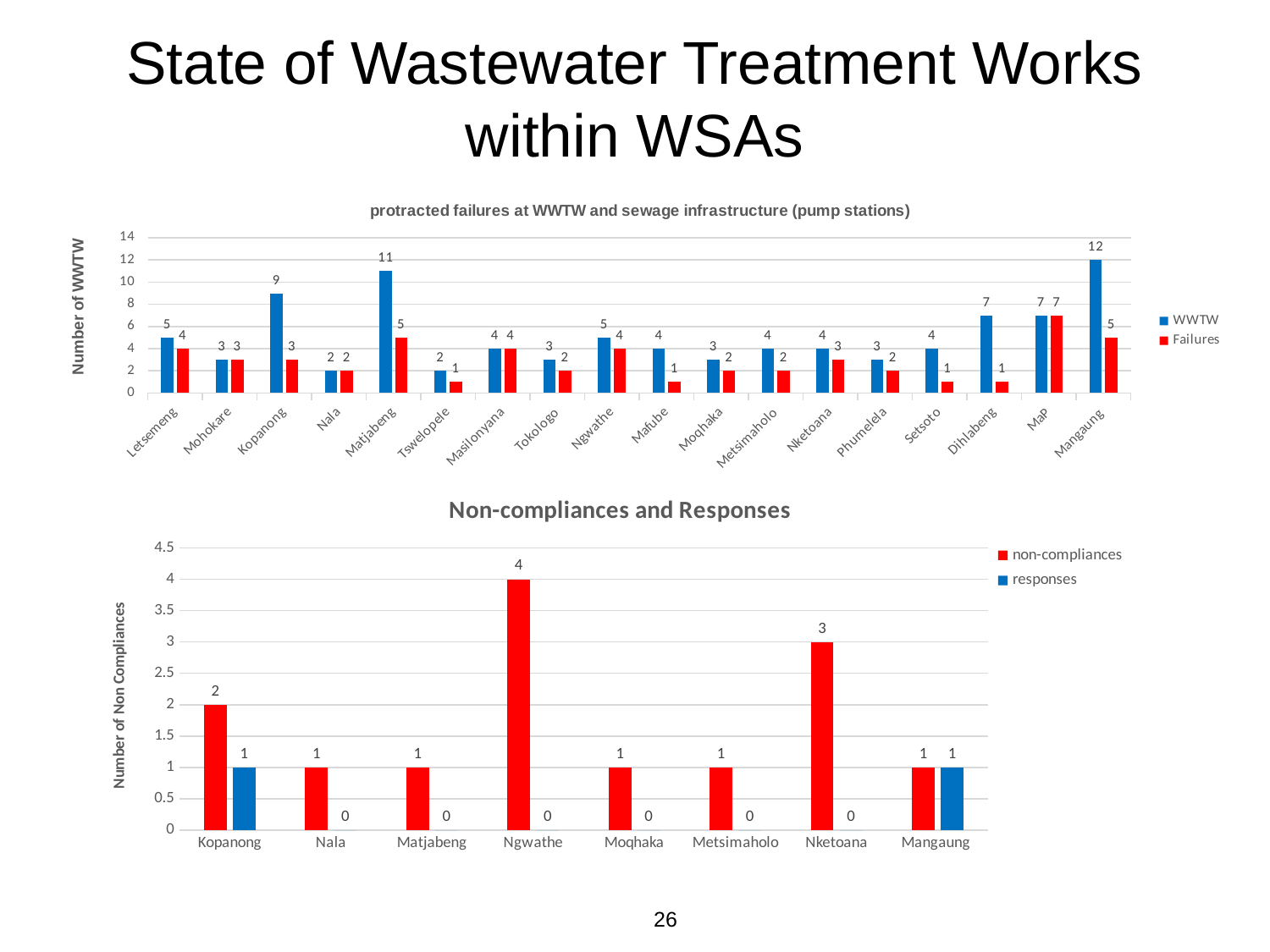
In the top chart (protracted failures at WWTW and sewage infrastructure), which category has the highest WWTW value? Mangaung In the bottom chart (Non-compliances and Responses), which category has the highest non-compliances value? Ngwathe In the top chart (protracted failures at WWTW and sewage infrastructure), which category has the highest Failures value? MaP In the bottom chart (Non-compliances and Responses), what is the non-compliances value for Ngwathe? 4 In the bottom chart (Non-compliances and Responses), what is the responses value for Kopanong? 1 In the top chart (protracted failures at WWTW and sewage infrastructure), what is the WWTW value for Matjabeng? 11 In the bottom chart (Non-compliances and Responses), how many categories are shown on the x axis? 8 In the bottom chart (Non-compliances and Responses), which is larger: the non-compliances value for Nketoana or for Kopanong? Nketoana In the top chart (protracted failures at WWTW and sewage infrastructure), what is the Failures value for Dihlabeng? 1 In the top chart (protracted failures at WWTW and sewage infrastructure), how many series does the legend list? 2 What kind of chart is the bottom chart (Non-compliances and Responses)? Bar chart In the top chart (protracted failures at WWTW and sewage infrastructure), what is the difference between the WWTW and Failures values for Kopanong? 6